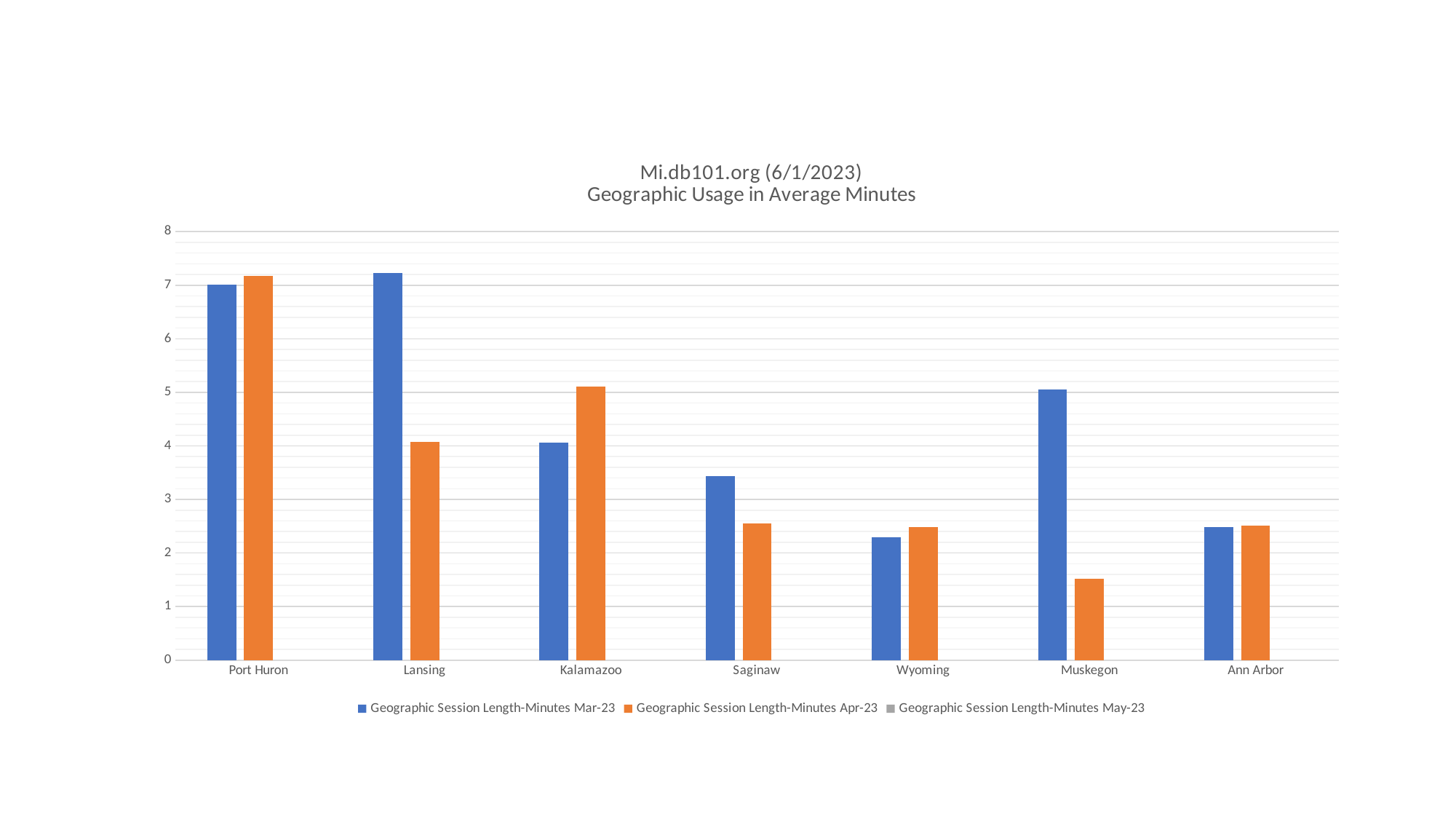
For Lansing, which is larger: the Mar-23 value or the Apr-23 value? Mar-23 What is the title of the chart? Mi.db101.org (6/1/2023) Geographic Usage in Average Minutes What kind of chart is shown on the slide? bar chart Is the Geographic Session Length-Minutes Mar-23 value for Saginaw greater or less than 3? greater Is the Geographic Session Length-Minutes Apr-23 value for Lansing greater or less than 5? less How many series does the chart's legend list? 3 Is the Geographic Session Length-Minutes Apr-23 value for Muskegon greater or less than 2? less How many cities are shown on the x axis of the chart? 7 Which city has the lowest Geographic Session Length-Minutes Apr-23 value? Muskegon For Kalamazoo, which is larger: the Mar-23 value or the Apr-23 value? Apr-23 Which city has the highest Geographic Session Length-Minutes Apr-23 value? Port Huron